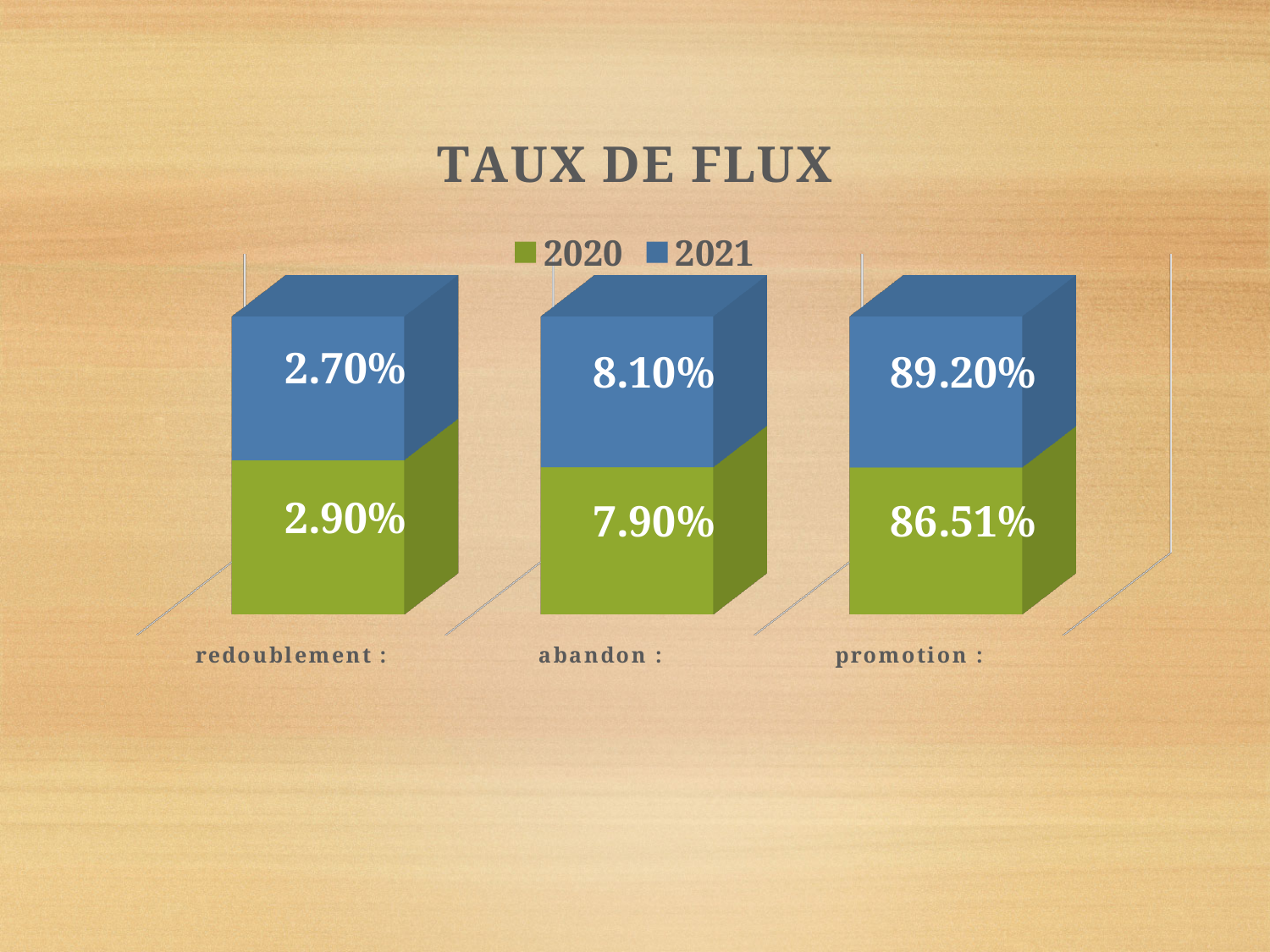
What is the value for 2021 in the abandon category? 8.10% What is the difference between the 2021 and 2020 values for promotion? 2.69 percentage points Which category has the lowest value for the 2020 series? redoublement What is the value for 2020 in the redoublement category? 2.90% How many categories are shown on the x axis? 3 What is the value for 2021 in the promotion category? 89.20% How many series does the legend list? 2 Which is larger for redoublement, the 2020 value or the 2021 value? 2020 What is the value for 2020 in the promotion category? 86.51% What is the title of the chart? TAUX DE FLUX Which category has the highest value for the 2021 series? promotion What kind of chart is shown on the slide? bar chart